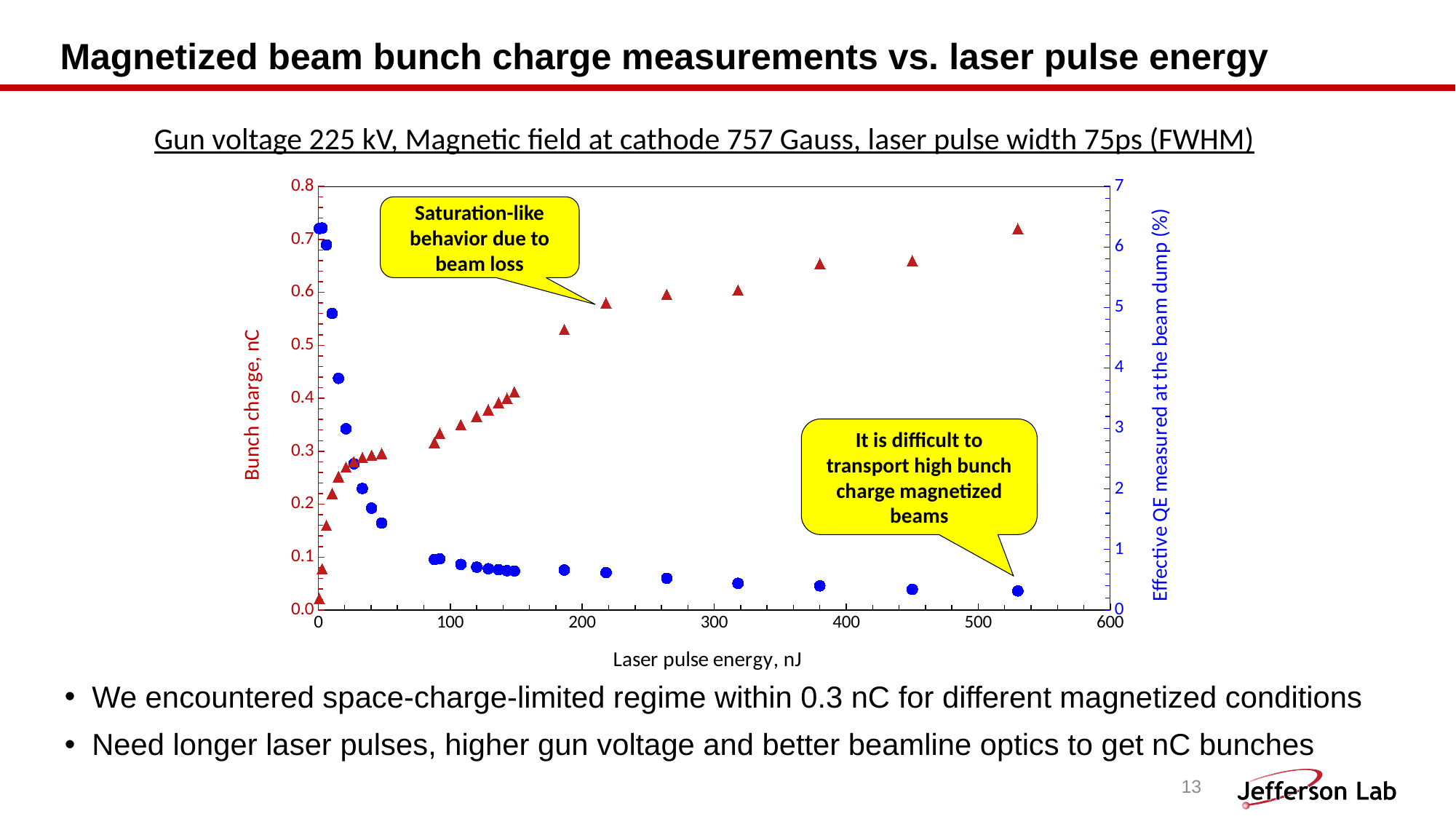
Is the bunch charge at about 185 nJ laser pulse energy greater or less than 0.4 nC? greater Do the bunch charge values (red triangles) rise or fall as laser pulse energy increases along the x axis? rise What does the yellow callout pointing at the red triangle near 220 nJ say? Saturation-like behavior due to beam loss Is the bunch charge at the highest laser pulse energy (about 530 nJ) greater or less than 0.6 nC? greater Is the effective QE at about 300 nJ laser pulse energy greater or less than 1%? less Do the effective QE values (blue circles) rise or fall as laser pulse energy increases along the x axis? fall What kind of chart is shown on the slide? scatter chart How many data series are plotted on the chart? 2 What is the label of the right-hand vertical axis? Effective QE measured at the beam dump (%)